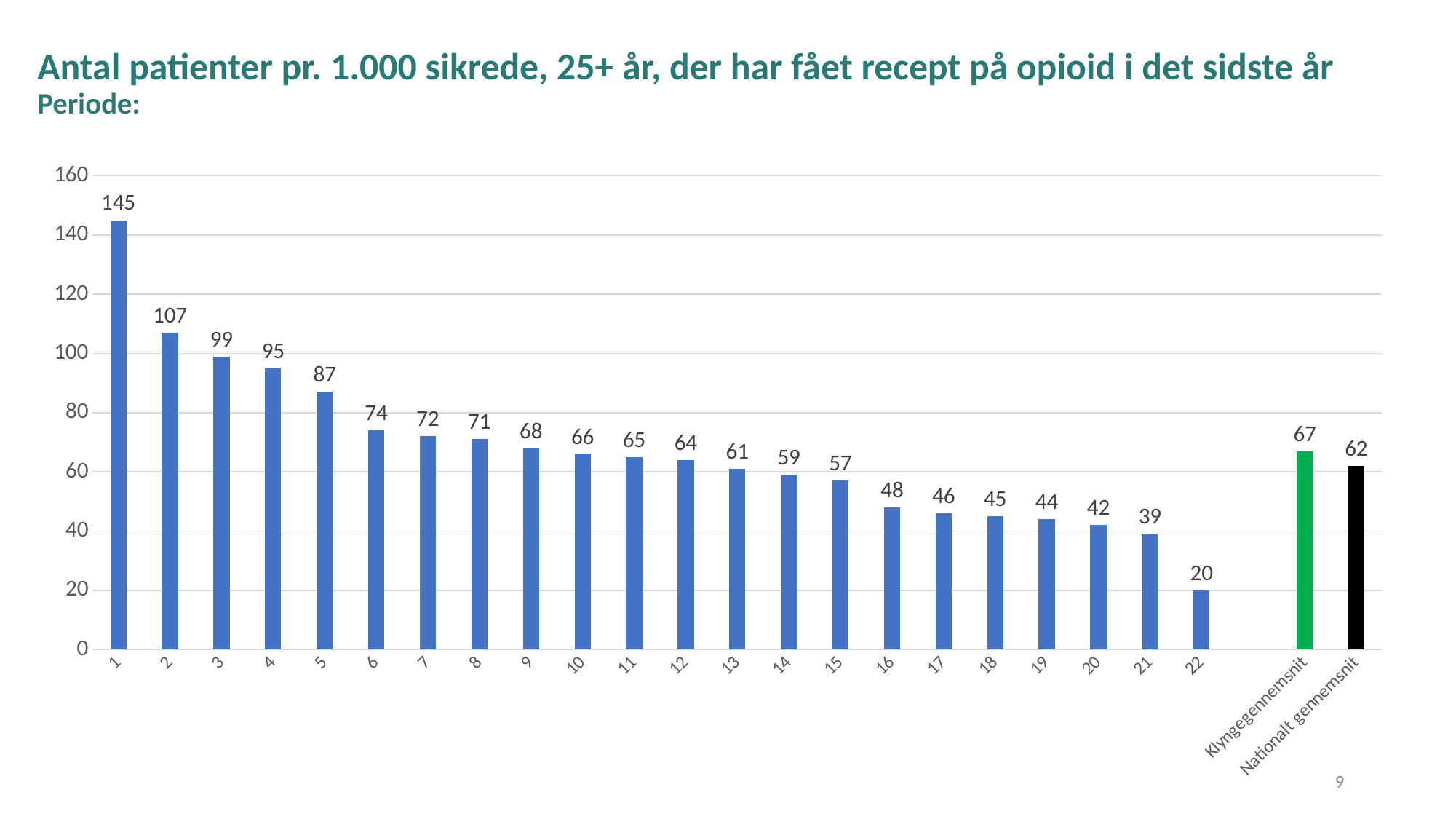
What is the value for category 15? 57 What is the value for Klyngegennemsnit? 67 Which numbered category has the lowest value? 22 Which is larger, the value for category 5 or the value for category 6? category 5 Do the values rise or fall from category 1 to category 22? fall What is the difference between Klyngegennemsnit and Nationalt gennemsnit? 5 Which numbered category has the highest value? 1 What is the difference between the values for category 1 and category 2? 38 What is the value for Nationalt gennemsnit? 62 What kind of chart is shown on the slide? bar chart What is the value for category 1? 145 How many numbered categories are shown on the x axis? 22